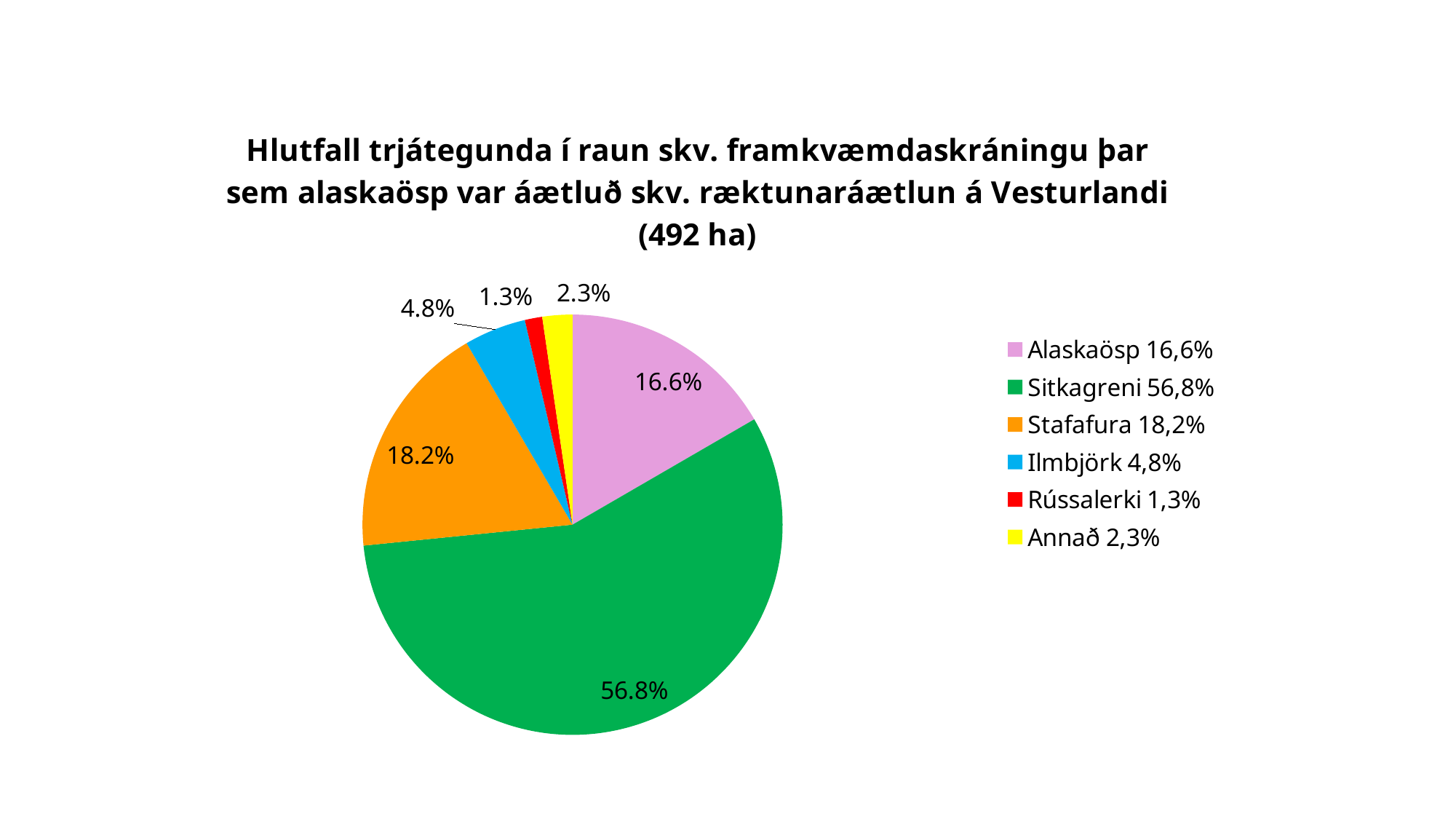
What colour is the Annað slice in the pie chart? yellow How many slices does the pie chart have? 6 What is the difference in percentage points between Sitkagreni and Stafafura? 38.6 What share of the pie does Rússalerki have? 1.3% What kind of chart is shown on the slide? pie chart What share of the pie does Sitkagreni have? 56.8% What share of the pie does Alaskaösp have? 16.6% Which tree species has the largest slice of the pie? Sitkagreni Which slice is larger, Stafafura or Alaskaösp? Stafafura Which tree species has the smallest slice of the pie? Rússalerki